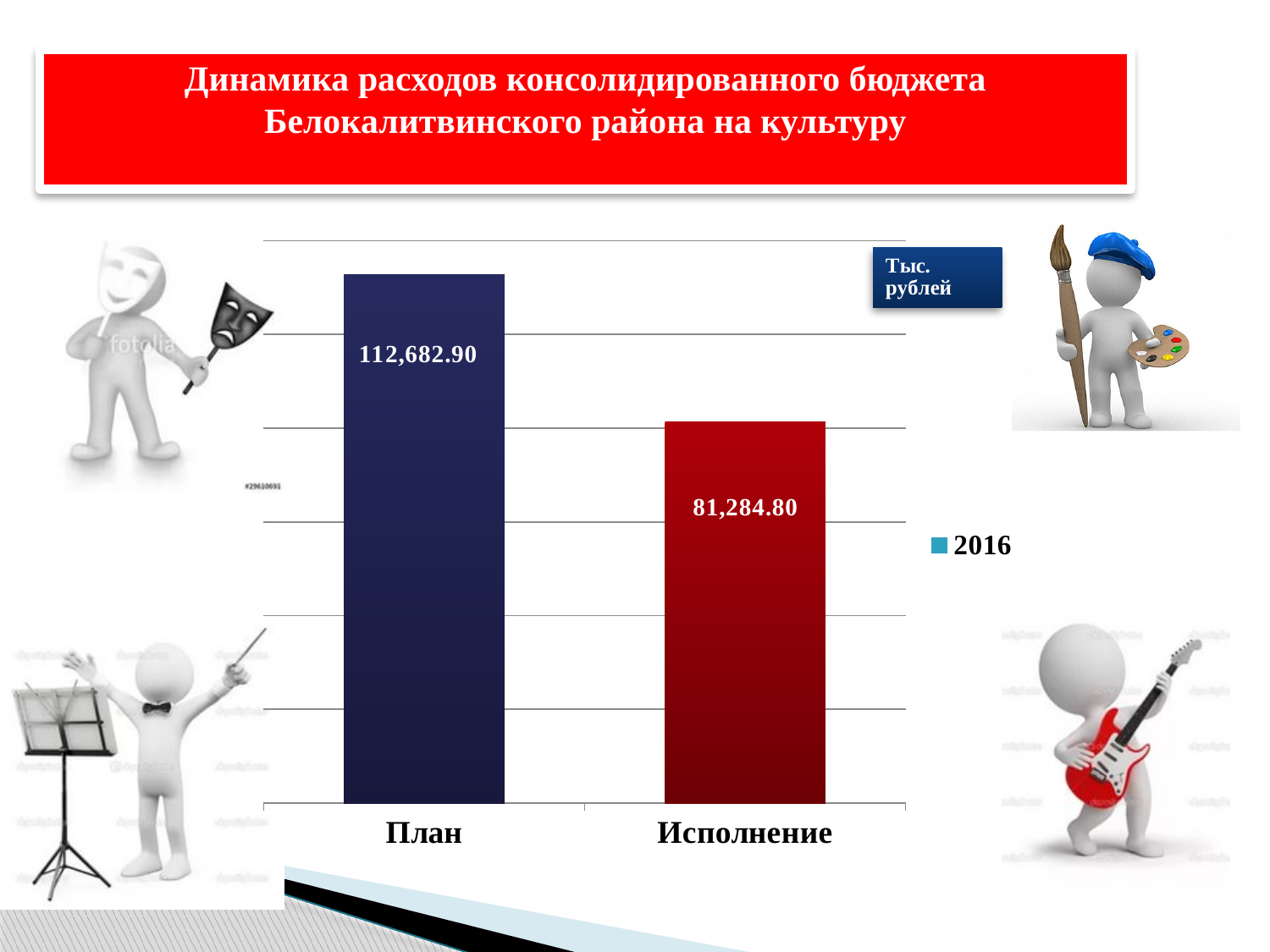
What is the value for План? 112,682.90 What is the value for Исполнение? 81,284.80 How many series does the legend list? 1 What is the difference between the values for План and Исполнение? 31,398.10 Which category has the highest value? План Do the values rise or fall from План to Исполнение? Fall How many categories are shown on the x axis? 2 Which category has the lowest value? Исполнение What series name is shown in the chart legend? 2016 What kind of chart is shown on the slide? Bar chart What unit of measurement is indicated in the box above the chart? Тыс. рублей Which is larger, the value for План or the value for Исполнение? План